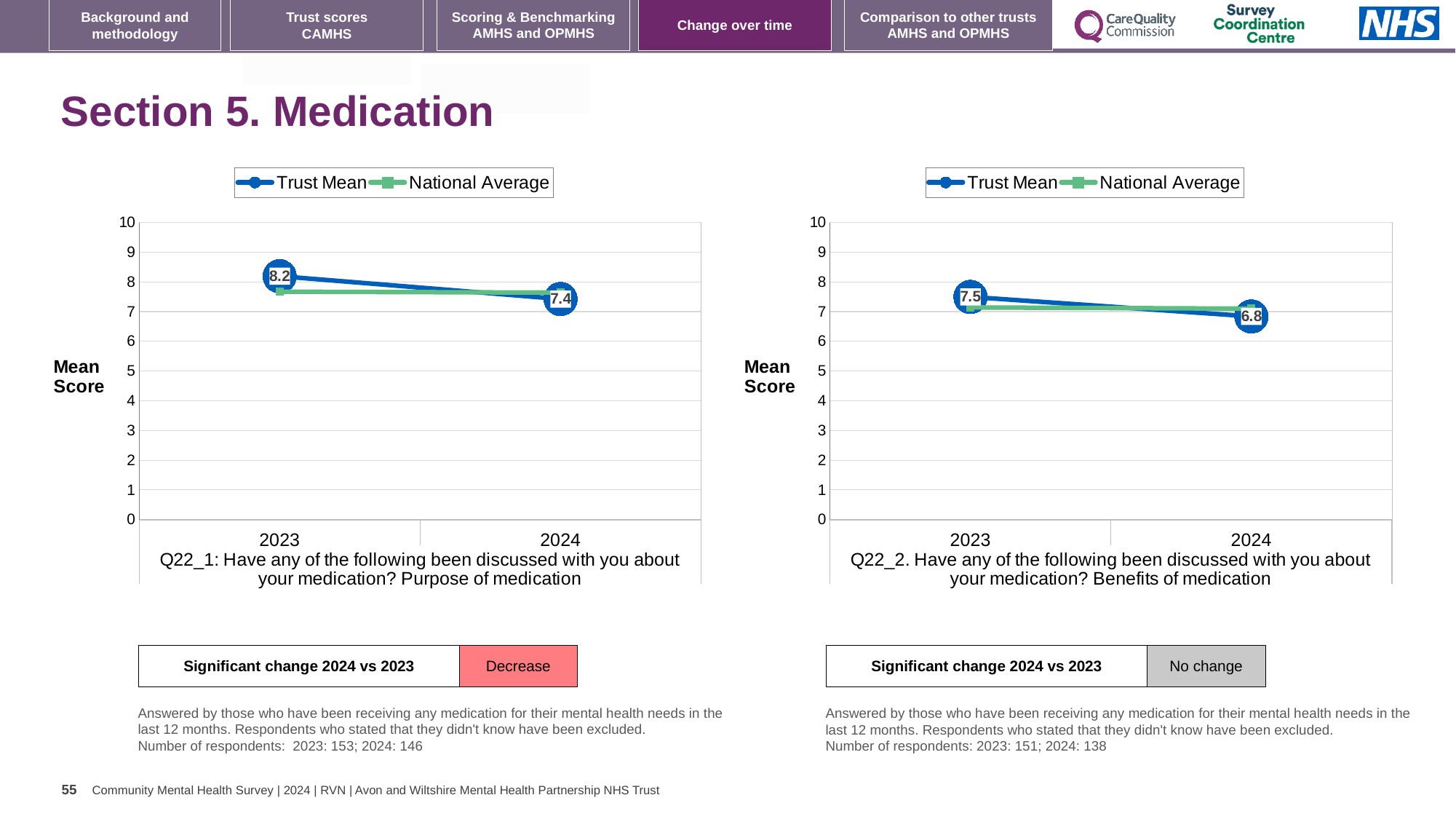
How many years are plotted on the x axis of the left chart (Q22_1: Purpose of medication)? 2 In the left chart (Q22_1: Purpose of medication), what is the Trust Mean for 2023? 8.2 In the left chart (Q22_1: Purpose of medication), what is the Trust Mean for 2024? 7.4 In the left chart (Q22_1: Purpose of medication), does the Trust Mean rise or fall from 2023 to 2024? fall In the left chart (Q22_1: Purpose of medication), by how much did the Trust Mean fall from 2023 to 2024? 0.8 In the right chart (Q22_2: Benefits of medication), what is the Trust Mean for 2024? 6.8 In the right chart (Q22_2: Benefits of medication), what is the Trust Mean for 2023? 7.5 In the left chart (Q22_1: Purpose of medication), which is larger in 2023, the Trust Mean or the National Average? Trust Mean In the right chart (Q22_2: Benefits of medication), what is the difference between the Trust Mean in 2023 and in 2024? 0.7 How many series does the legend of the right chart (Q22_2: Benefits of medication) list? 2 In the right chart (Q22_2: Benefits of medication), is the National Average for 2023 greater or less than 8? less What type of chart is used on this slide? line chart